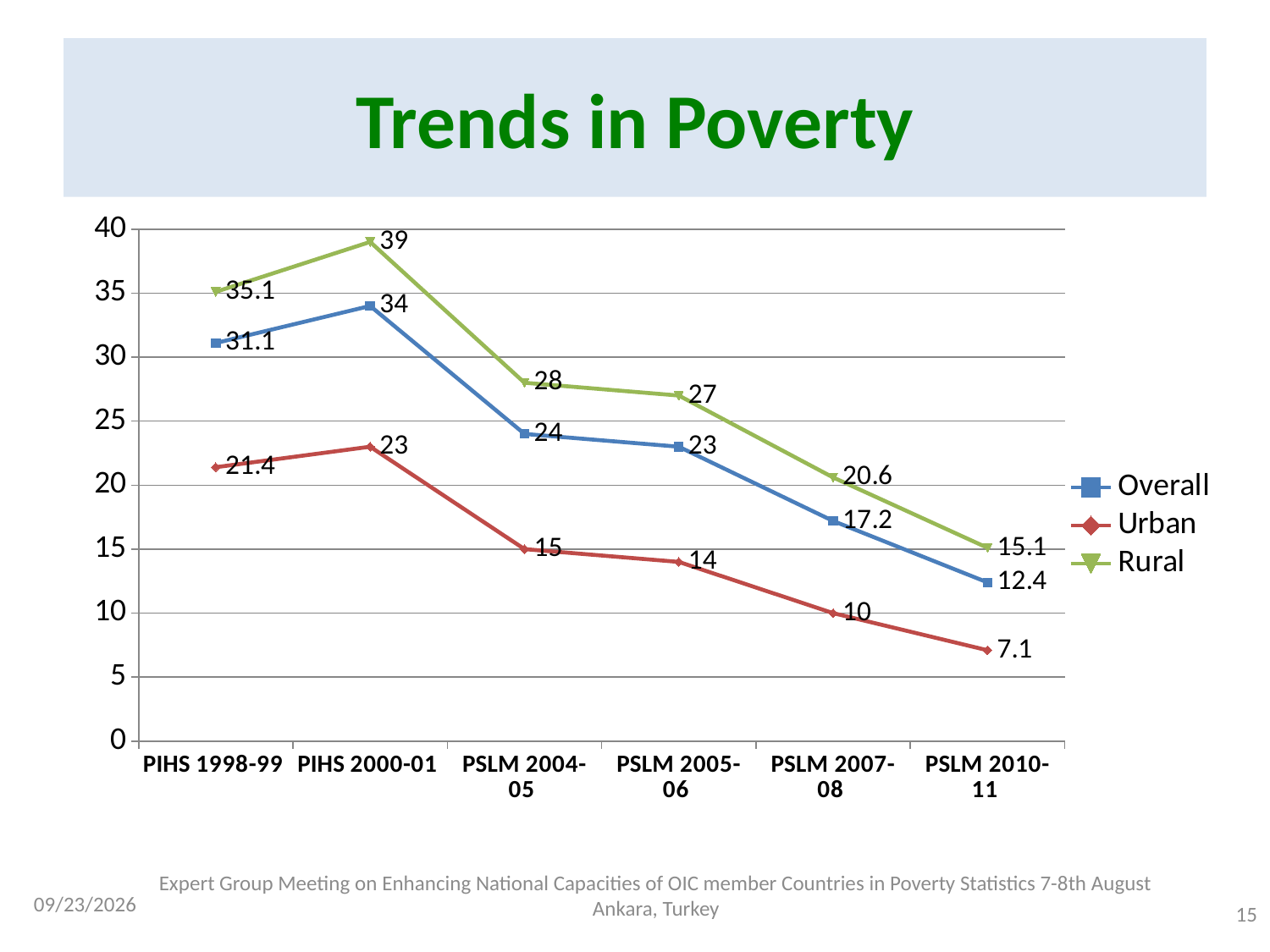
Which is larger, the Overall value for PIHS 1998-99 or the Overall value for PIHS 2000-01? PIHS 2000-01 Which survey has the highest Rural value? PIHS 2000-01 What kind of chart is shown on the slide? line chart What is the Rural value for PIHS 2000-01? 39 What is the Urban value for PSLM 2010-11? 7.1 How many surveys are shown on the x axis? 6 How many series does the legend list? 3 Which survey has the lowest Overall value? PSLM 2010-11 What is the Overall value for PSLM 2007-08? 17.2 What is the difference between the Rural and Urban values for PSLM 2004-05? 13 From PIHS 2000-01 to PSLM 2010-11, do the Overall values rise or fall? fall Is the Urban value for PSLM 2005-06 greater or less than 15? less